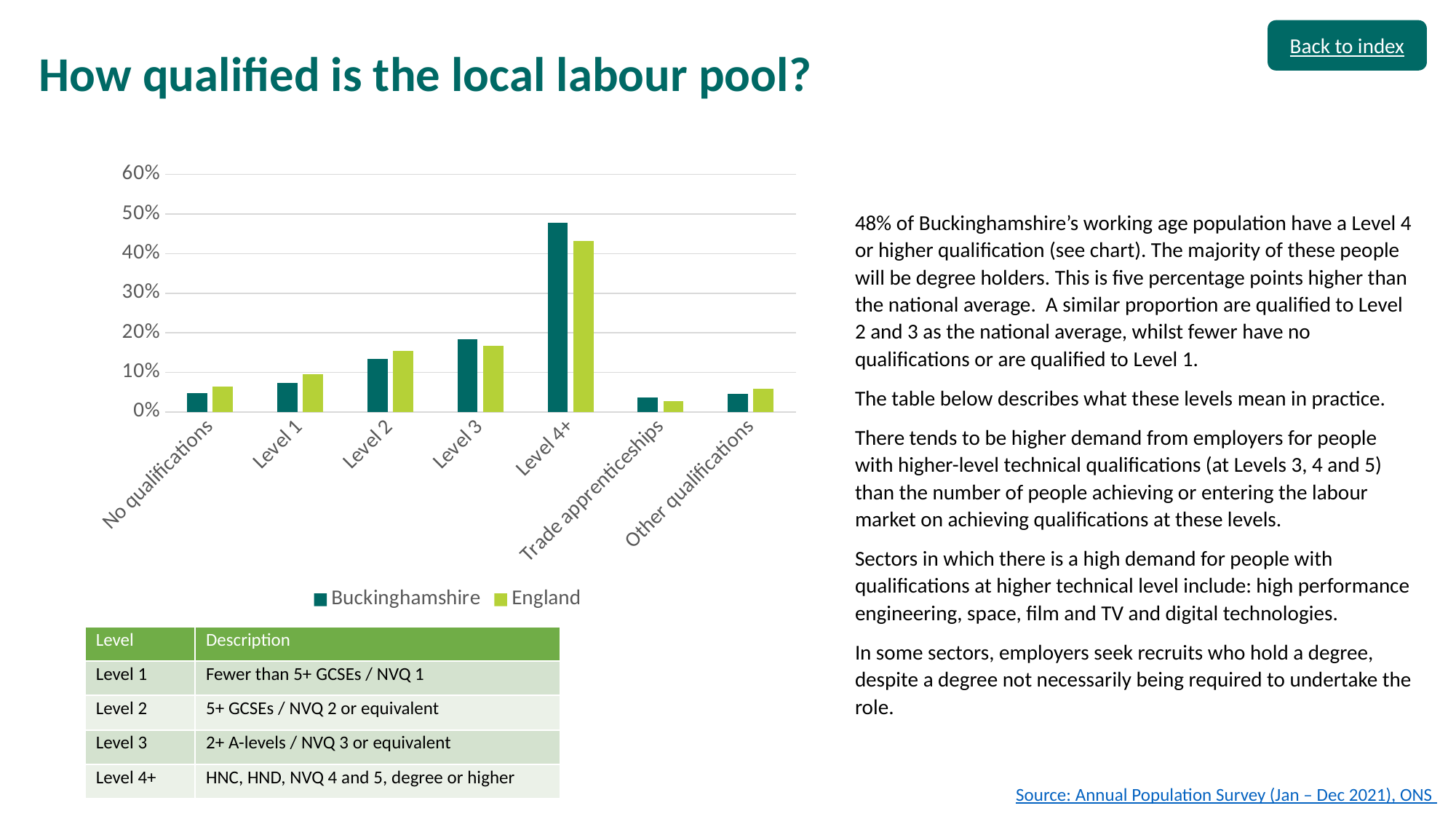
Which qualification category has the highest value for Buckinghamshire? Level 4+ For Level 4+, which is larger: Buckinghamshire or England? Buckinghamshire What kind of chart is shown on the slide? Bar chart For Level 2, which is larger: Buckinghamshire or England? England How many qualification categories are shown on the x axis of the chart? 7 Which qualification category has the highest value for England? Level 4+ Is the Buckinghamshire value for Level 4+ greater or less than 40%? greater How many series does the chart legend list? 2 Is the Buckinghamshire value for Level 3 greater or less than 20%? less Which qualification category has the lowest value for England? Trade apprenticeships For Level 1, which is larger: Buckinghamshire or England? England Which two series are listed in the chart legend? Buckinghamshire and England